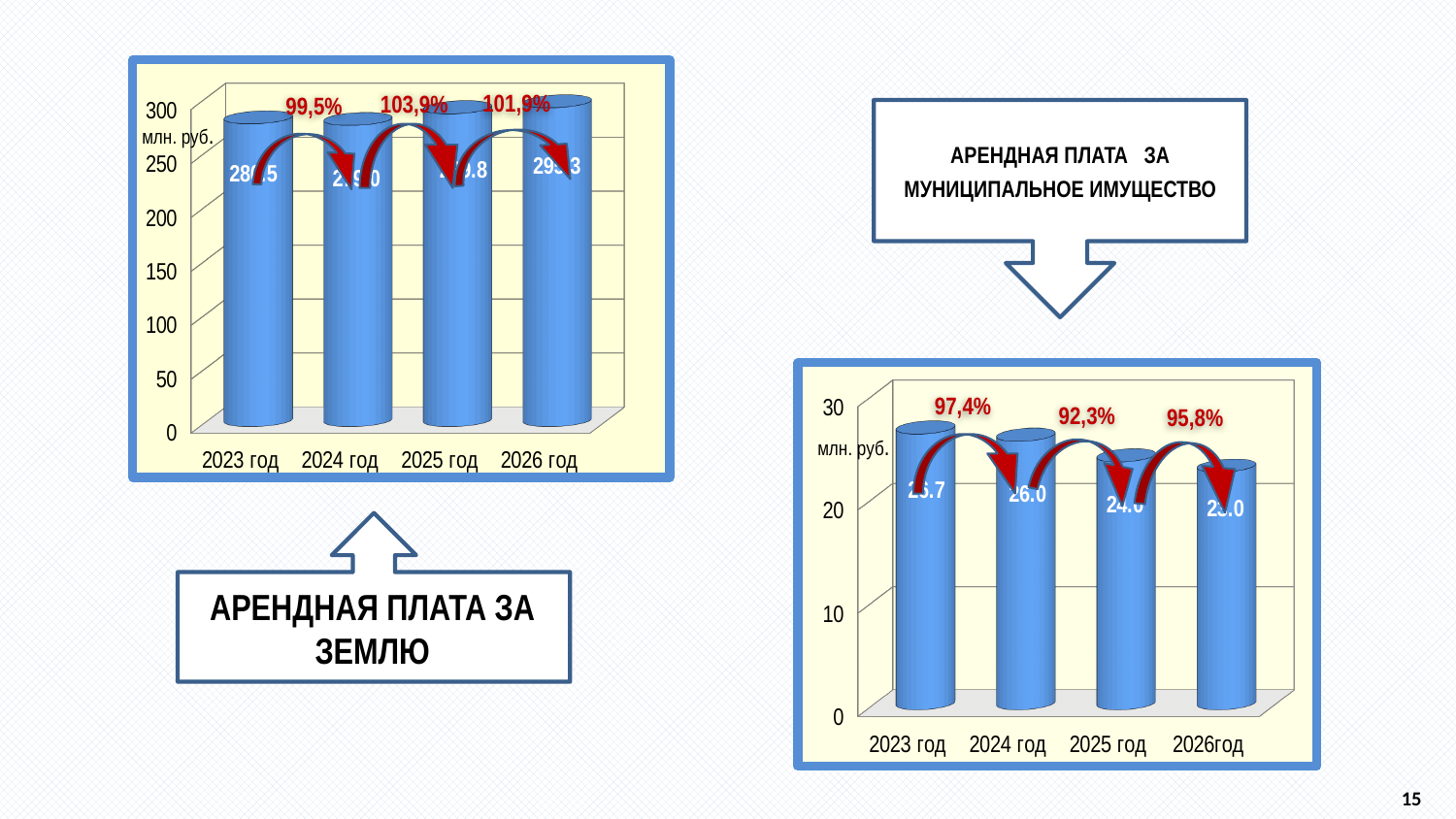
In the chart titled «АРЕНДНАЯ ПЛАТА ЗА МУНИЦИПАЛЬНОЕ ИМУЩЕСТВО», which is larger, the value for 2023 год or the value for 2026год? 2023 год In the chart titled «АРЕНДНАЯ ПЛАТА ЗА МУНИЦИПАЛЬНОЕ ИМУЩЕСТВО», is the value for 2026год greater or less than 20? greater In the chart titled «АРЕНДНАЯ ПЛАТА ЗА МУНИЦИПАЛЬНОЕ ИМУЩЕСТВО», which year has the lowest value? 2026год In the chart titled «АРЕНДНАЯ ПЛАТА ЗА ЗЕМЛЮ», is the value for 2023 год greater or less than 250? greater In the chart titled «АРЕНДНАЯ ПЛАТА ЗА МУНИЦИПАЛЬНОЕ ИМУЩЕСТВО», which year has the highest value? 2023 год What unit is shown on the vertical axis of the chart titled «АРЕНДНАЯ ПЛАТА ЗА ЗЕМЛЮ»? млн. руб. How many years are shown on the x axis of the chart titled «АРЕНДНАЯ ПЛАТА ЗА МУНИЦИПАЛЬНОЕ ИМУЩЕСТВО»? 4 In the chart titled «АРЕНДНАЯ ПЛАТА ЗА МУНИЦИПАЛЬНОЕ ИМУЩЕСТВО», do the values rise or fall from 2023 to 2026? Fall What kind of chart is the chart titled «АРЕНДНАЯ ПЛАТА ЗА ЗЕМЛЮ»? Bar chart In the chart titled «АРЕНДНАЯ ПЛАТА ЗА МУНИЦИПАЛЬНОЕ ИМУЩЕСТВО», what is the value for 2024 год? 26.0 In the chart titled «АРЕНДНАЯ ПЛАТА ЗА ЗЕМЛЮ», what percentage is printed above the arrow from 2024 год to 2025 год? 103,9% In the chart titled «АРЕНДНАЯ ПЛАТА ЗА МУНИЦИПАЛЬНОЕ ИМУЩЕСТВО», what percentage is printed above the arrow from 2024 год to 2025 год? 92,3%